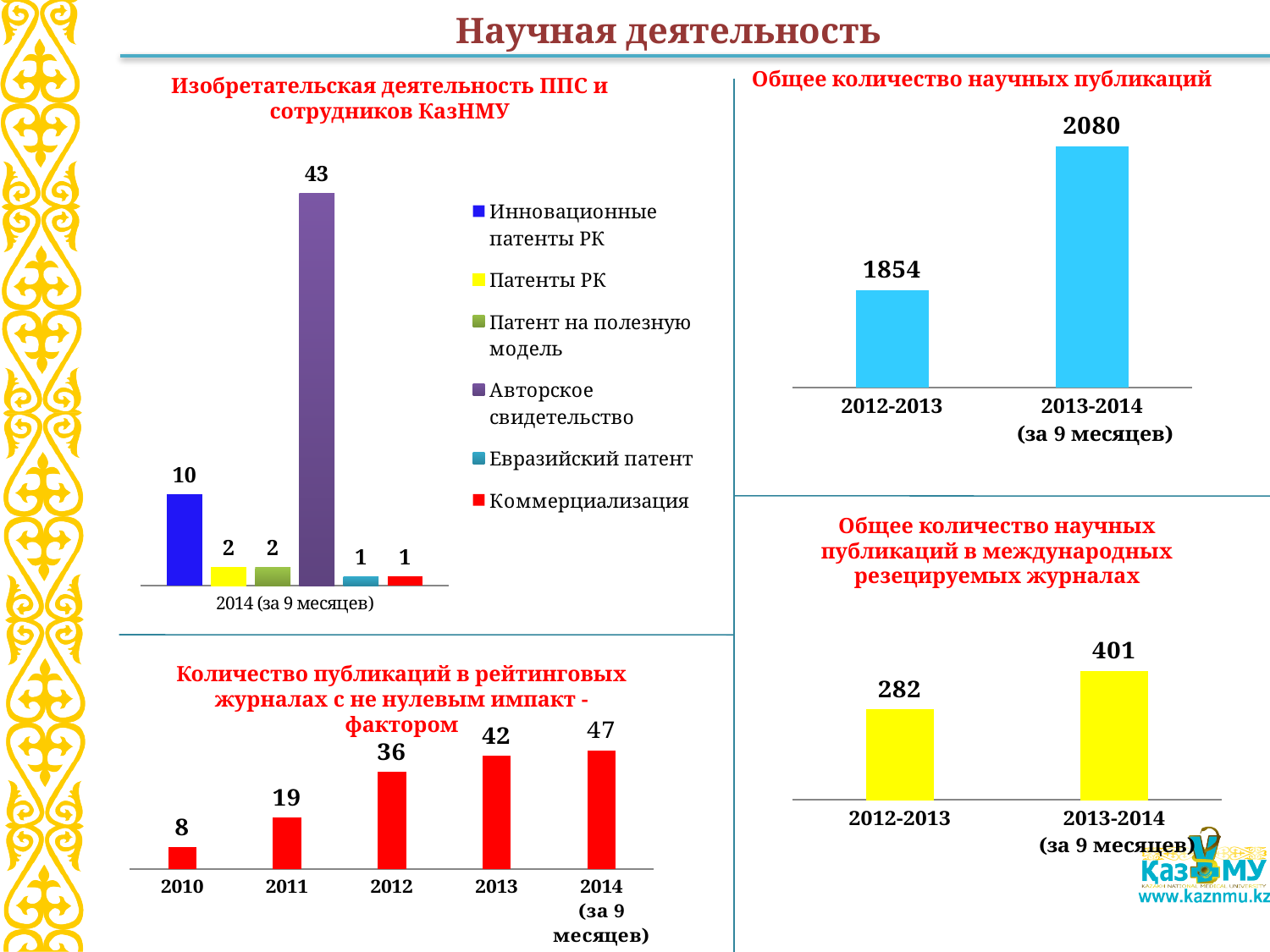
In the chart 'Количество публикаций в рейтинговых журналах с не нулевым импакт-фактором', how many categories are shown on the x axis? 5 In the chart 'Количество публикаций в рейтинговых журналах с не нулевым импакт-фактором', do the values rise or fall from 2010 to 2014? rise In the chart 'Изобретательская деятельность ППС и сотрудников КазНМУ', what is the value for 'Инновационные патенты РК'? 10 In the chart 'Количество публикаций в рейтинговых журналах с не нулевым импакт-фактором', which year has the lowest value? 2010 In the chart 'Общее количество научных публикаций', what is the value for 2012-2013? 1854 In the chart 'Изобретательская деятельность ППС и сотрудников КазНМУ', which series has the highest value? Авторское свидетельство What kind of chart is 'Общее количество научных публикаций в международных резецируемых журналах'? bar chart In the chart 'Изобретательская деятельность ППС и сотрудников КазНМУ', what is the value for 'Авторское свидетельство'? 43 In the chart 'Общее количество научных публикаций в международных резецируемых журналах', what is the value for 2013-2014 (за 9 месяцев)? 401 In the chart 'Количество публикаций в рейтинговых журналах с не нулевым импакт-фактором', what is the value for 2012? 36 In the chart 'Изобретательская деятельность ППС и сотрудников КазНМУ', how many series does the legend list? 6 In the chart 'Общее количество научных публикаций', what is the difference between the 2013-2014 (за 9 месяцев) value and the 2012-2013 value? 226